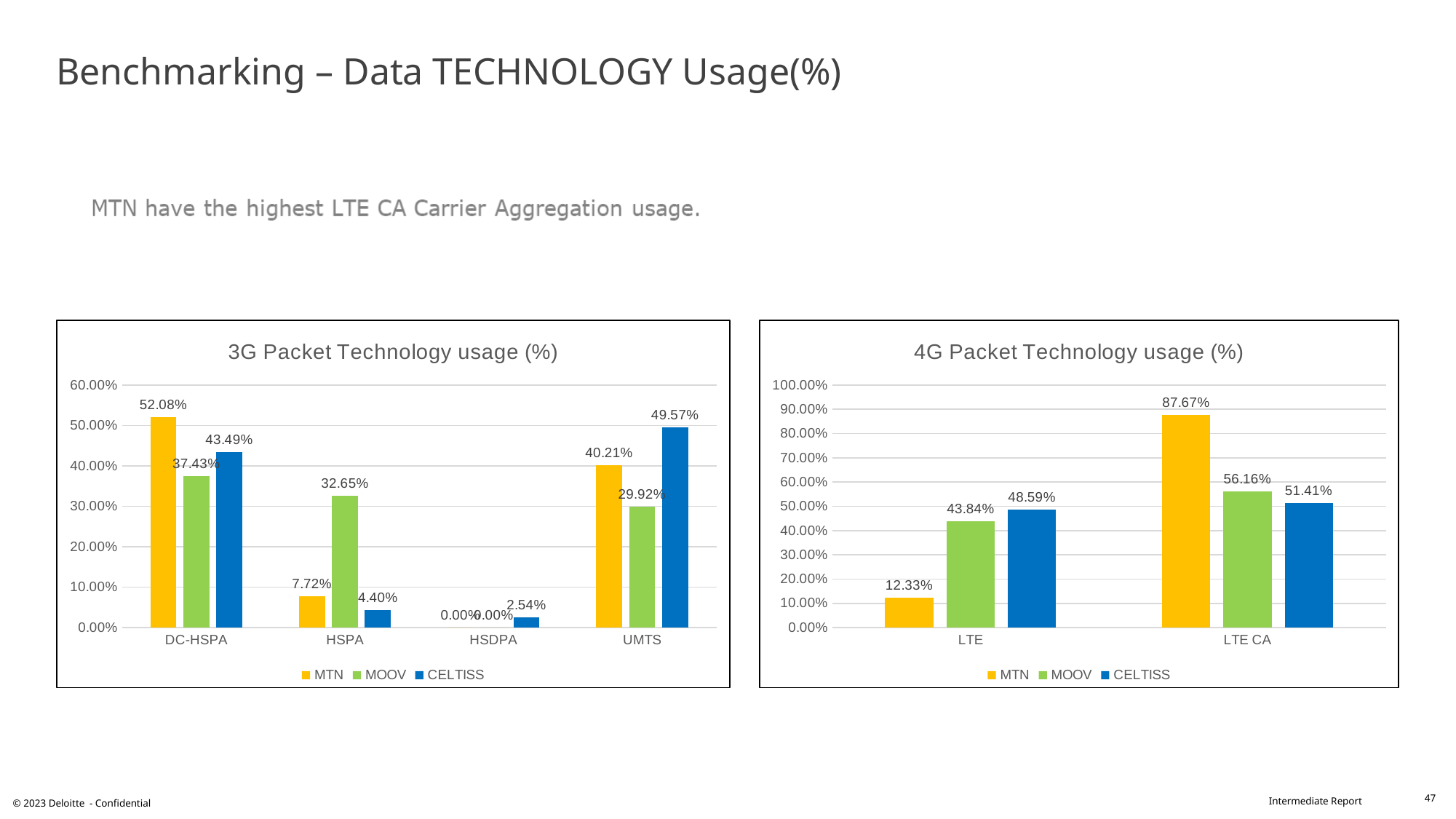
In the '3G Packet Technology usage (%)' chart, is the MTN value for UMTS greater or less than the CELTISS value for UMTS? less In the '4G Packet Technology usage (%)' chart, what is the value for MTN in the LTE CA category? 87.67% In the '4G Packet Technology usage (%)' chart, what is the difference between the MOOV and CELTISS values for LTE CA? 4.75% In the '4G Packet Technology usage (%)' chart, which series has the lowest value in the LTE category? MTN In the '3G Packet Technology usage (%)' chart, how many categories are shown on the x axis? 4 In the '3G Packet Technology usage (%)' chart, what is the value for CELTISS in the UMTS category? 49.57% In the '3G Packet Technology usage (%)' chart, what is the value for MTN in the DC-HSPA category? 52.08% In the '4G Packet Technology usage (%)' chart, how many series does the legend list? 3 In the '3G Packet Technology usage (%)' chart, which series has the highest value in the HSPA category? MOOV In the '4G Packet Technology usage (%)' chart, which colour represents the CELTISS series? Blue What type of chart is the '4G Packet Technology usage (%)' chart? Bar chart In the '3G Packet Technology usage (%)' chart, what is the difference between the MTN and MOOV values for DC-HSPA? 14.65%